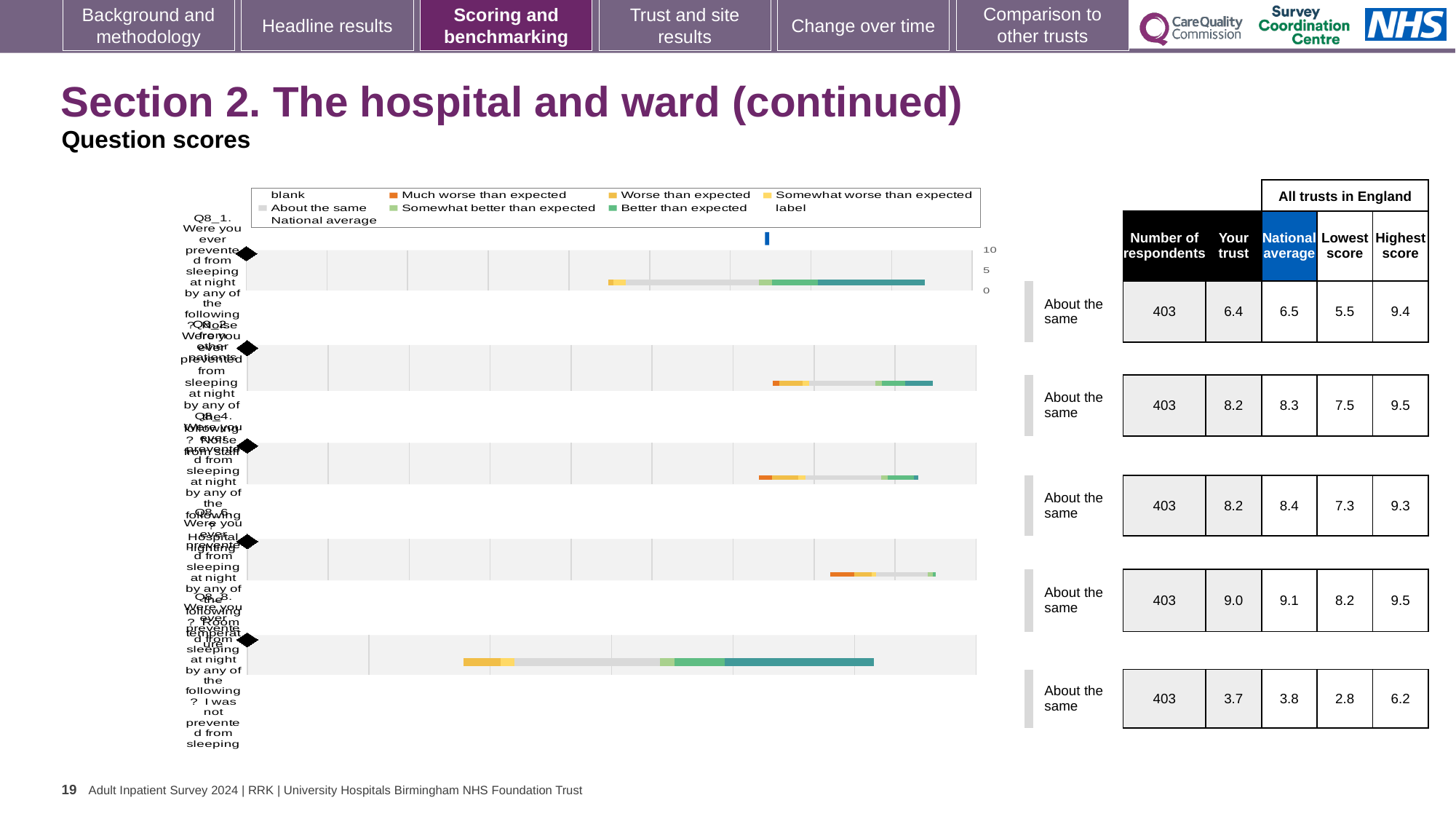
In the table beside the chart, what is the 'National average' in the bottom row? 3.8 In the table beside the chart, which row has the highest 'Your trust' score? the fourth row (9.0) In the chart legend, which category is shown in dark teal? Better than expected In the first row of the table beside the chart, which is larger: 'Your trust' or 'National average'? National average In the table beside the chart, what is the difference between the 'Highest score' and 'Lowest score' in the second row? 2.0 What benchmark category is shown next to every question row on the slide? About the same In the table beside the chart, which row has the lowest 'Your trust' score? the bottom row (3.7) How many question rows (bars) are plotted in the chart? 5 In the table beside the chart, what is the 'Your trust' score in the first row? 6.4 How many respondents are listed for each question row in the table beside the chart? 403 What kind of chart is shown on the slide? bar chart What is the highest tick value shown on the chart's axis? 10